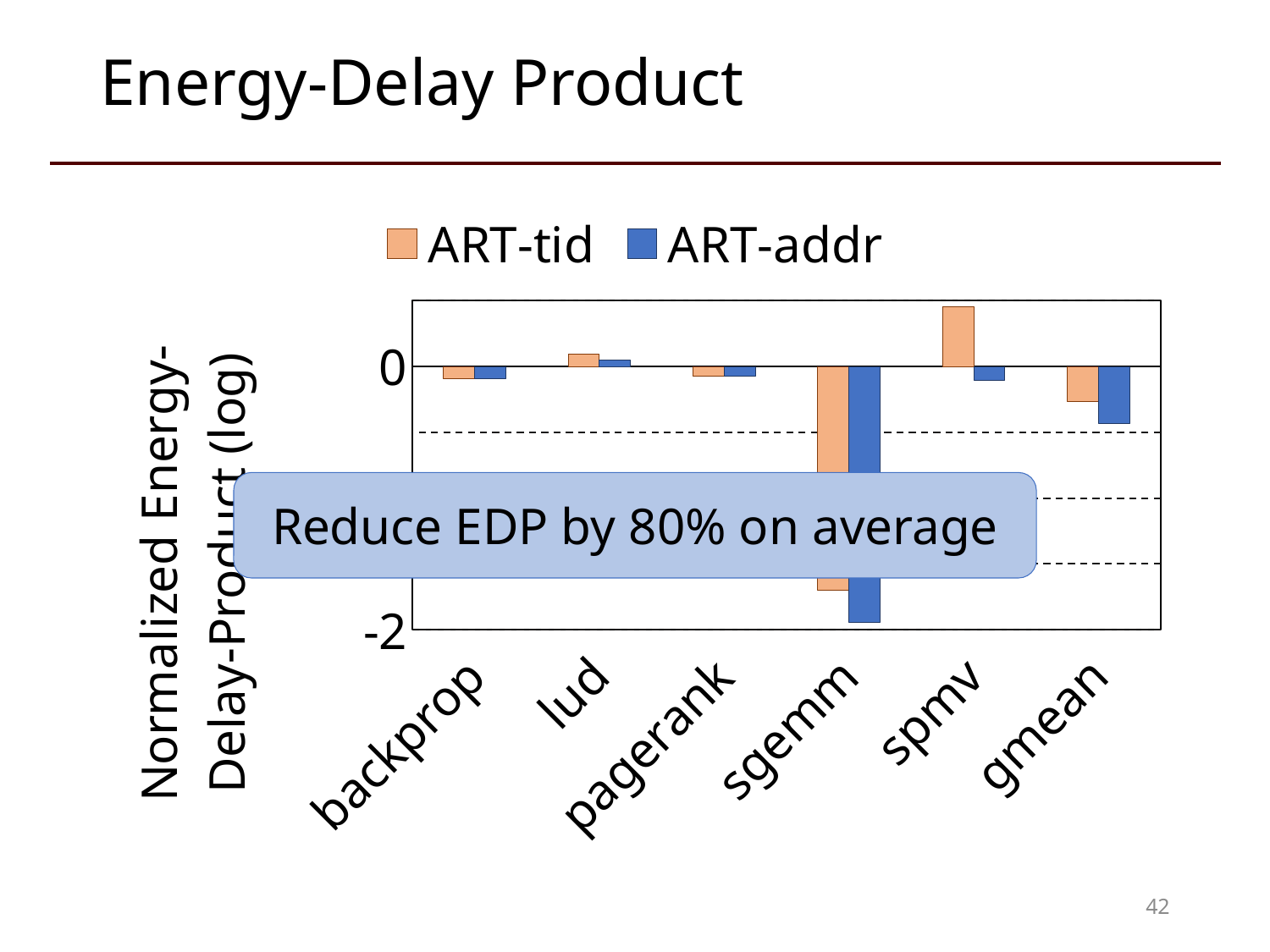
Is the ART-addr value for sgemm greater or less than 0? less How many series does the legend list? 2 What is the title of the chart? Energy-Delay Product For sgemm, which series has the larger value, ART-tid or ART-addr? ART-tid How many categories are shown on the x axis? 6 Which category has the lowest ART-addr value? sgemm Is the ART-tid value for spmv greater or less than 0? greater For gmean, which series has the larger value, ART-tid or ART-addr? ART-tid Is the ART-tid value for lud greater or less than 0? greater What kind of chart is shown on the slide? bar chart Which category has the highest ART-tid value? spmv Which series are listed in the legend? ART-tid and ART-addr